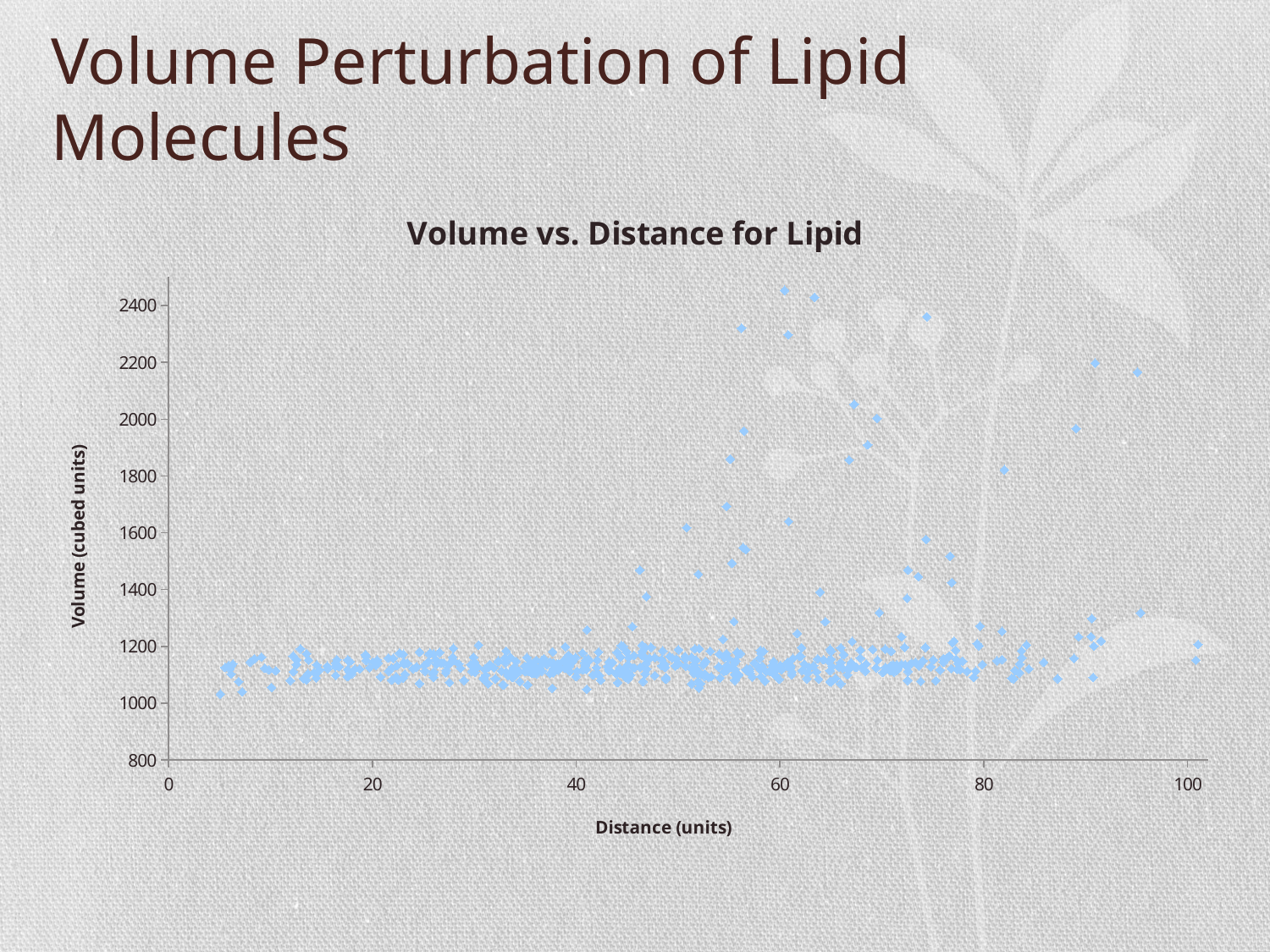
What kind of chart is shown on the slide? Scatter chart Is the highest plotted volume value greater or less than 2200? greater Between which two labelled y-axis ticks does the dense band of points lie? 1000 and 1200 What is the label of the vertical axis of the chart? Volume (cubed units) Is the lowest plotted volume value greater or less than 1200? less What is the title of the chart? Volume vs. Distance for Lipid